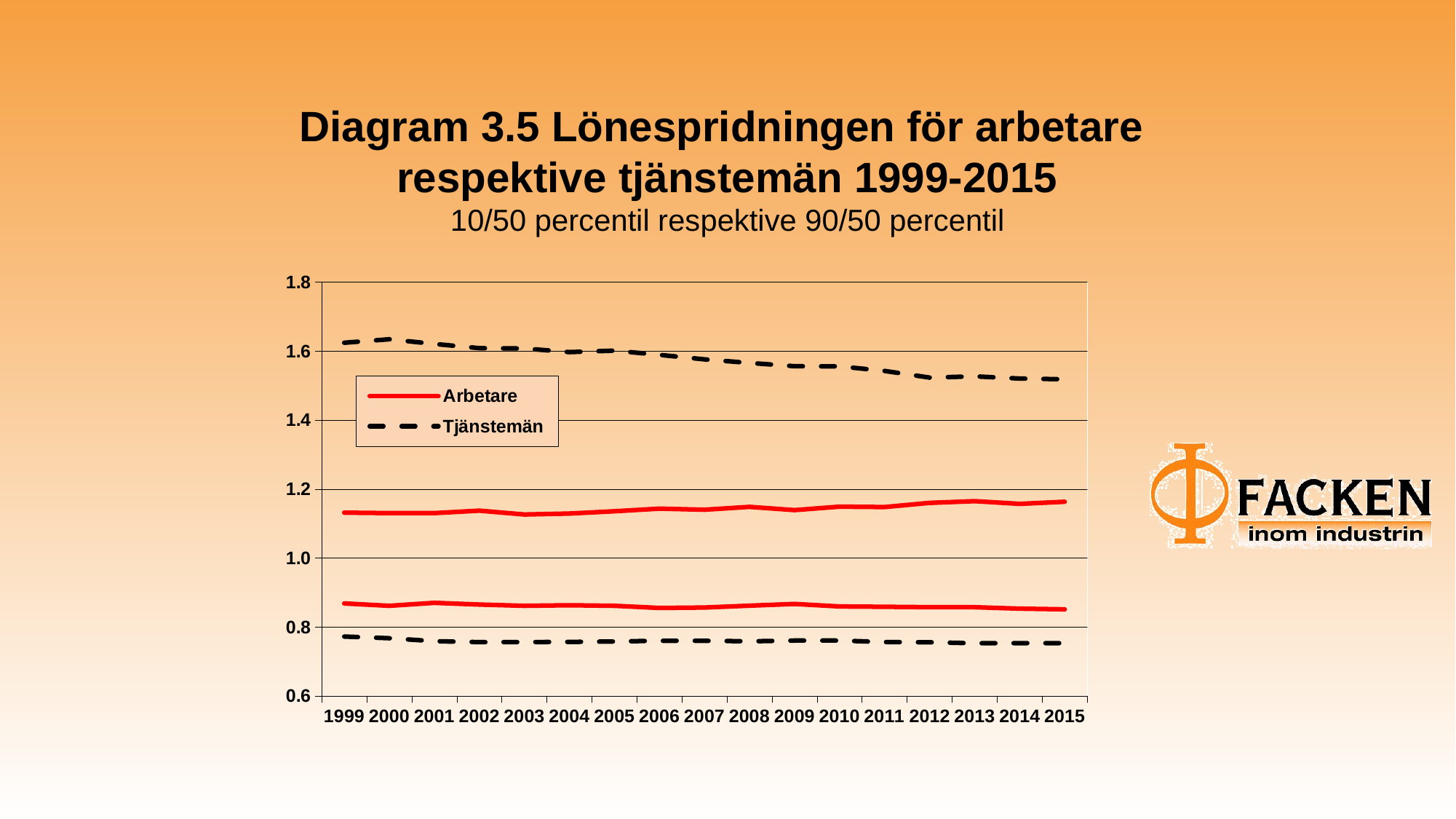
Is the value of the upper Arbetare line in 2015 greater or less than 1.2? less Is the value of the lower Arbetare line in 1999 greater or less than 0.8? greater Is the value of the upper Tjänstemän line in 1999 greater or less than 1.4? greater How many series does the legend list? 2 What is the title of the chart? Diagram 3.5 Lönespridningen för arbetare respektive tjänstemän 1999-2015 Which two series are listed in the legend? Arbetare and Tjänstemän In 2015, which upper line is higher: Arbetare or Tjänstemän? Tjänstemän Does the upper Tjänstemän line rise or fall from 1999 to 2015? fall How many years are shown on the x axis? 17 What kind of chart is shown on the slide? line chart